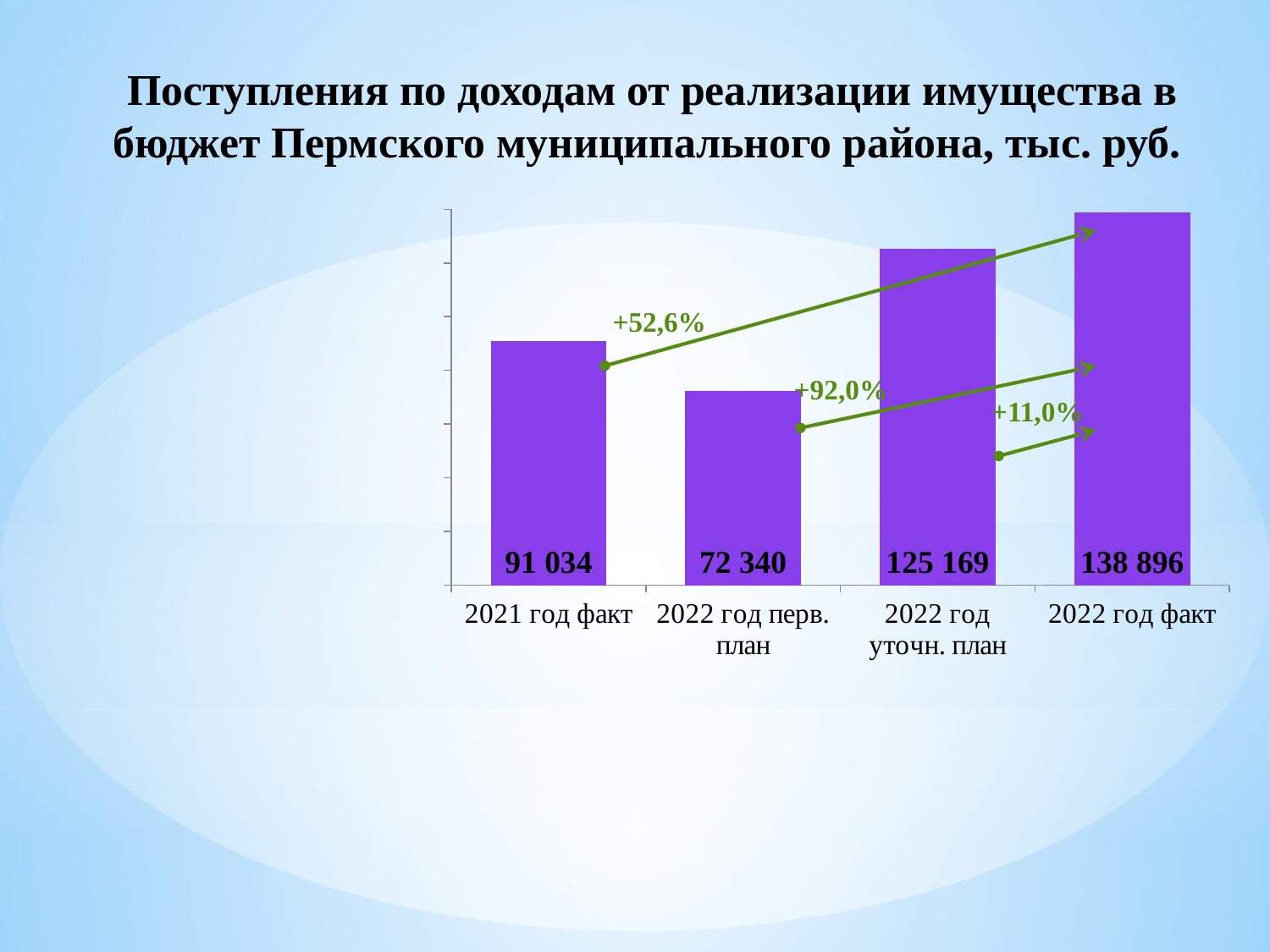
How many categories are shown on the x axis? 4 Which category has the highest value? 2022 год факт Which category has the lowest value? 2022 год перв. план What percentage change is annotated between 2022 год уточн. план and 2022 год факт? +11,0% What is the difference between the values for 2022 год факт and 2022 год уточн. план? 13 727 What is the value for 2021 год факт? 91 034 What is the value for 2022 год факт? 138 896 What is the value for 2022 год перв. план? 72 340 What is the difference between the values for 2021 год факт and 2022 год перв. план? 18 694 What kind of chart is shown on the slide? Bar chart Which is larger, the value for 2021 год факт or the value for 2022 год перв. план? 2021 год факт What is the value for 2022 год уточн. план? 125 169